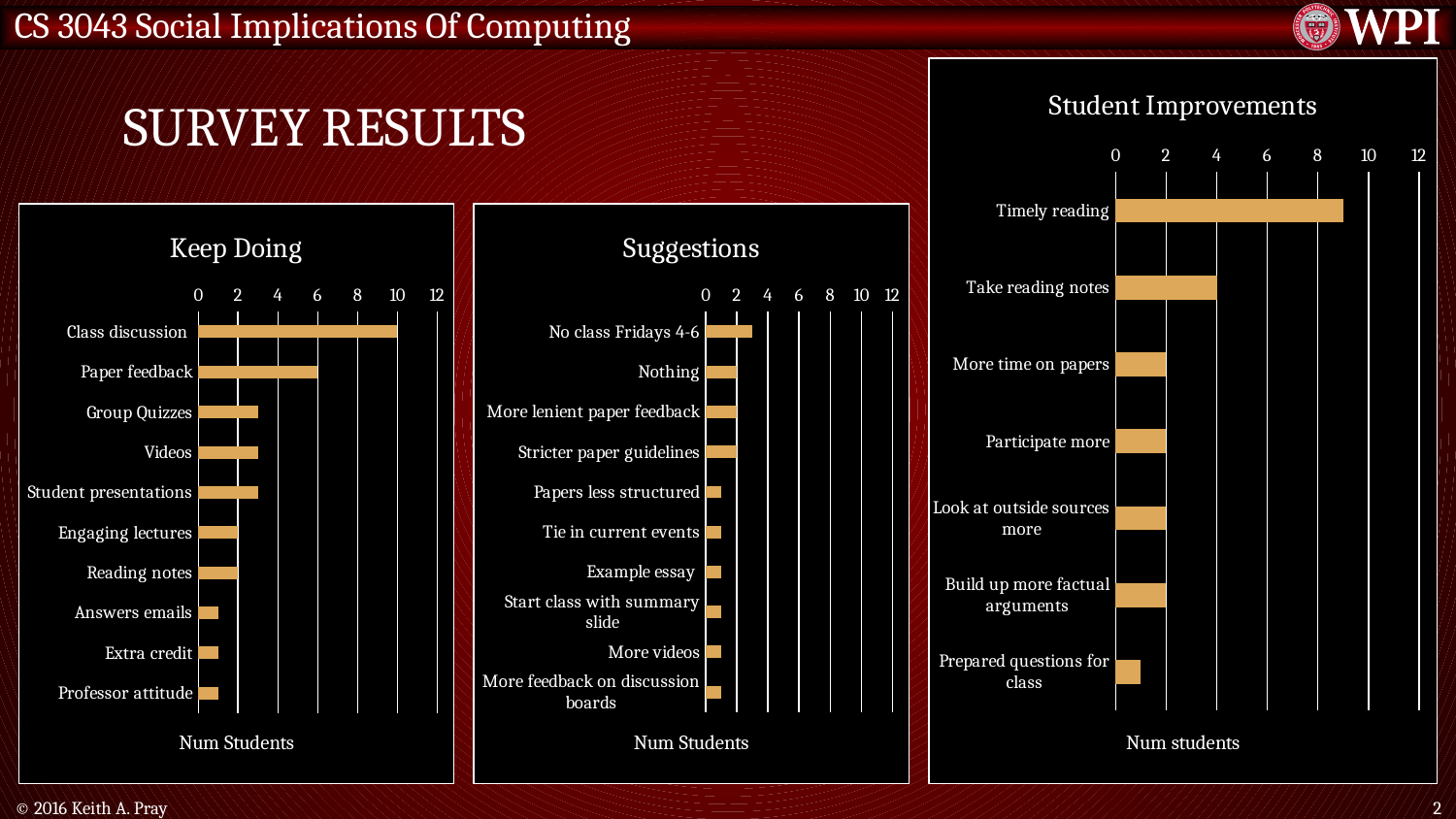
In the Keep Doing chart, is the value for Paper feedback greater or less than 4? greater How many categories are shown in the Student Improvements chart? 7 What type of chart is the Student Improvements chart? bar chart In the Keep Doing chart, which category has the highest value? Class discussion In the Suggestions chart, is the value for No class Fridays 4-6 greater or less than 2? greater How many categories are shown in the Suggestions chart? 10 In the Suggestions chart, which category has the highest value? No class Fridays 4-6 In the Student Improvements chart, is the value for Timely reading greater or less than 8? greater In the Student Improvements chart, which category has the lowest value? Prepared questions for class In the Keep Doing chart, what is the value for Class discussion? 10 How many categories are shown in the Keep Doing chart? 10 In the Student Improvements chart, which category has the highest value? Timely reading